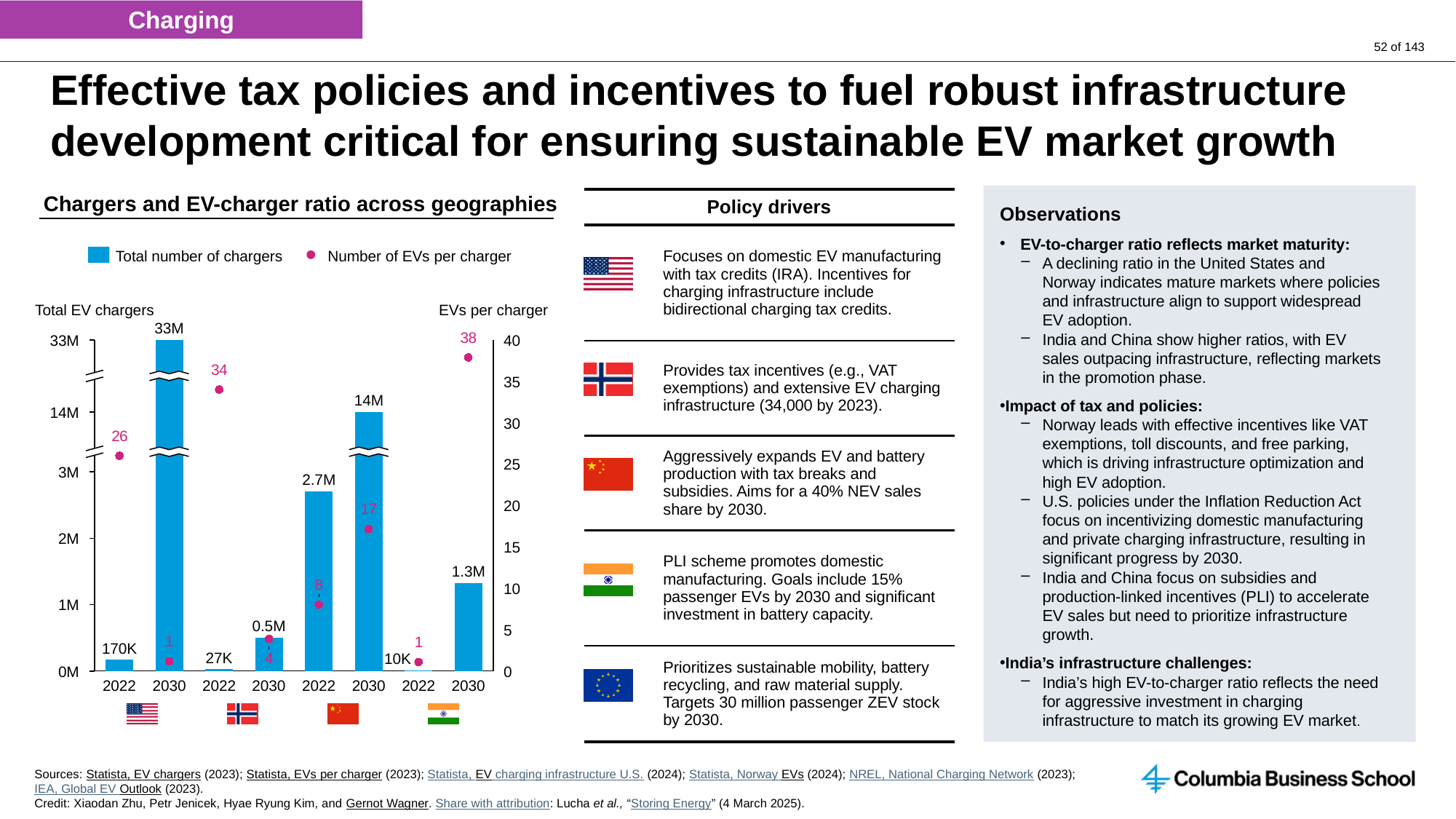
What type of chart is used for 'Chargers and EV-charger ratio across geographies'? Bar chart with dot markers (combination chart) How many series does the legend of the 'Chargers and EV-charger ratio across geographies' chart list? 2 In the 'Chargers and EV-charger ratio across geographies' chart, which is larger: the total number of chargers for China in 2030 or for India in 2030? China 2030 In the 'Chargers and EV-charger ratio across geographies' chart, which country-year has the highest total number of chargers? United States 2030 In the 'Chargers and EV-charger ratio across geographies' chart, which country-year has the lowest total number of chargers? India 2022 In the 'Chargers and EV-charger ratio across geographies' chart, what is the number of EVs per charger for India in 2030? 38 In the 'Chargers and EV-charger ratio across geographies' chart, what is the total number of chargers for the United States in 2030? 33M In the 'Chargers and EV-charger ratio across geographies' chart, what is the number of EVs per charger for China in 2022? 8 In the 'Chargers and EV-charger ratio across geographies' chart, what is the total number of chargers for Norway in 2022? 27K In the 'Chargers and EV-charger ratio across geographies' chart, which country-year has the highest number of EVs per charger? India 2030 How many bars are plotted in the 'Chargers and EV-charger ratio across geographies' chart? 8 In the 'Chargers and EV-charger ratio across geographies' chart, what is the difference in EVs per charger between Norway 2022 and Norway 2030? 30